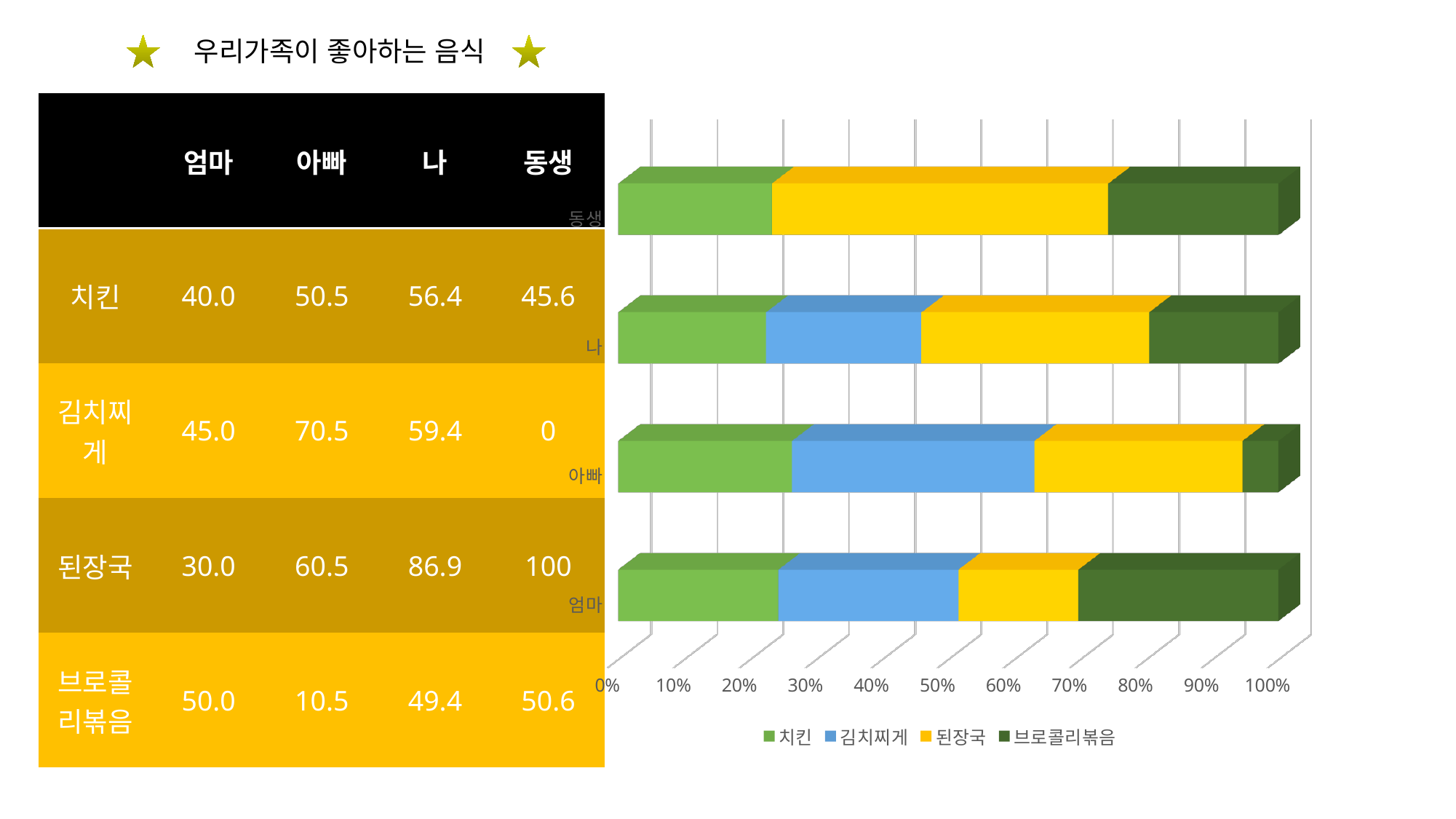
In the table on the slide, what is the 된장국 value for 나? 86.9 Which series has no segment in the 동생 bar of the chart? 김치찌게 What is the highest value shown on the chart's horizontal axis? 100% In the 아빠 bar of the chart, which segment is wider: 김치찌게 or 브로콜리볶음? 김치찌게 In the table on the slide, what is the 김치찌게 value for 동생? 0 What kind of chart is shown on the right side of the slide? stacked bar chart How many categories (family members) are plotted on the chart? 4 How many series does the chart legend list? 4 In the 동생 bar of the chart, which segment is wider: 된장국 or 치킨? 된장국 Which series is shown in blue in the chart legend? 김치찌게 In the table on the slide, which family member has the highest 된장국 value? 동생 In the 엄마 bar of the chart, which segment is wider: 브로콜리볶음 or 된장국? 브로콜리볶음